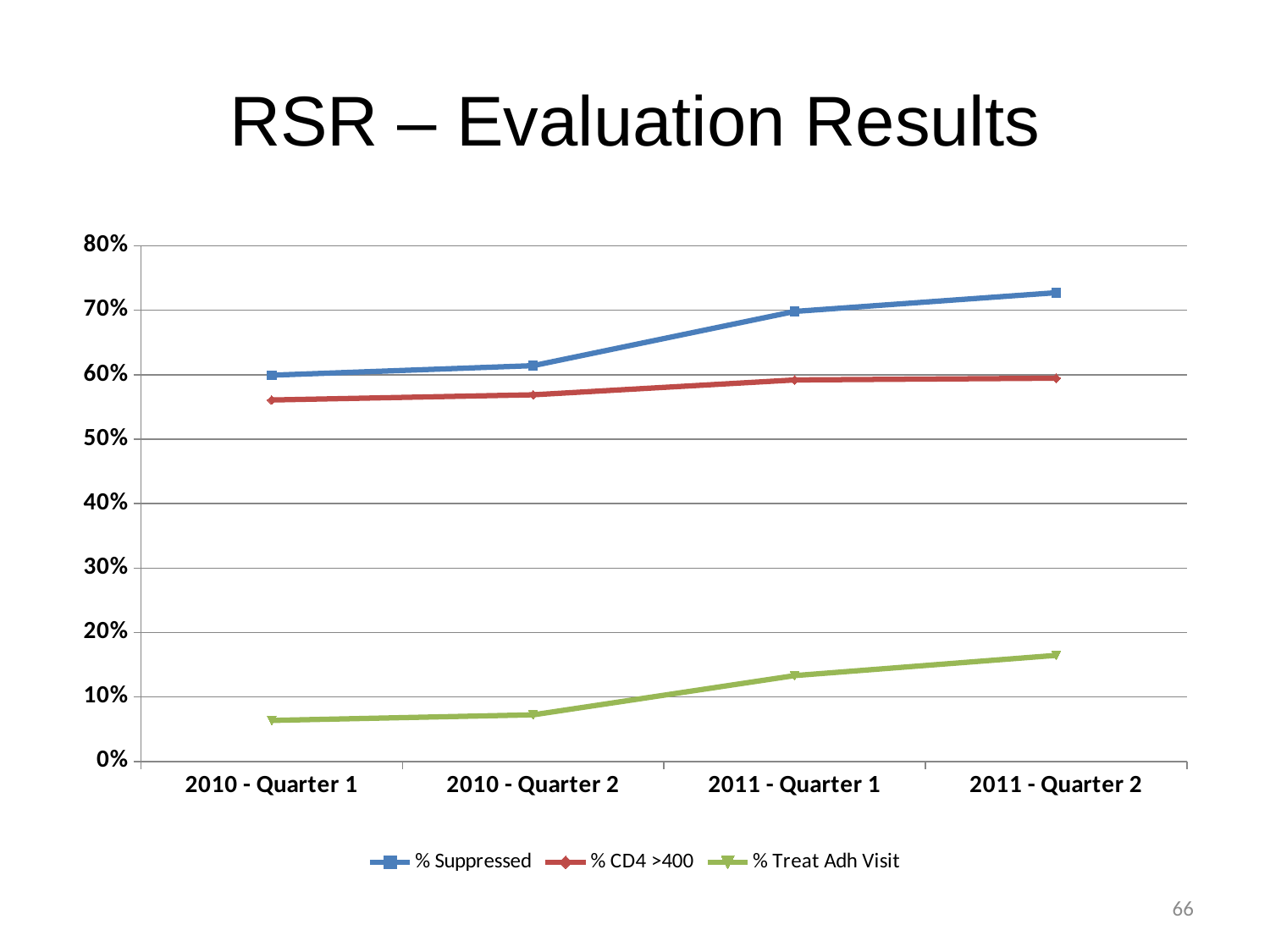
Is the value for % Suppressed at 2011 - Quarter 1 greater or less than 60%? greater Is the value for % Treat Adh Visit at 2010 - Quarter 1 greater or less than 10%? less Does the % Suppressed line rise or fall from 2010 - Quarter 1 to 2011 - Quarter 2? rise Is the value for % CD4 >400 at 2010 - Quarter 1 greater or less than 60%? less What kind of chart is shown on the slide? line chart How many quarters are plotted along the x axis? 4 Does the % Treat Adh Visit line rise or fall across the quarters shown? rise How many series does the legend list? 3 What is the title of the slide containing the chart? RSR – Evaluation Results At 2011 - Quarter 1, which is larger: % Suppressed or % CD4 >400? % Suppressed Which series has the lowest values across all quarters? % Treat Adh Visit